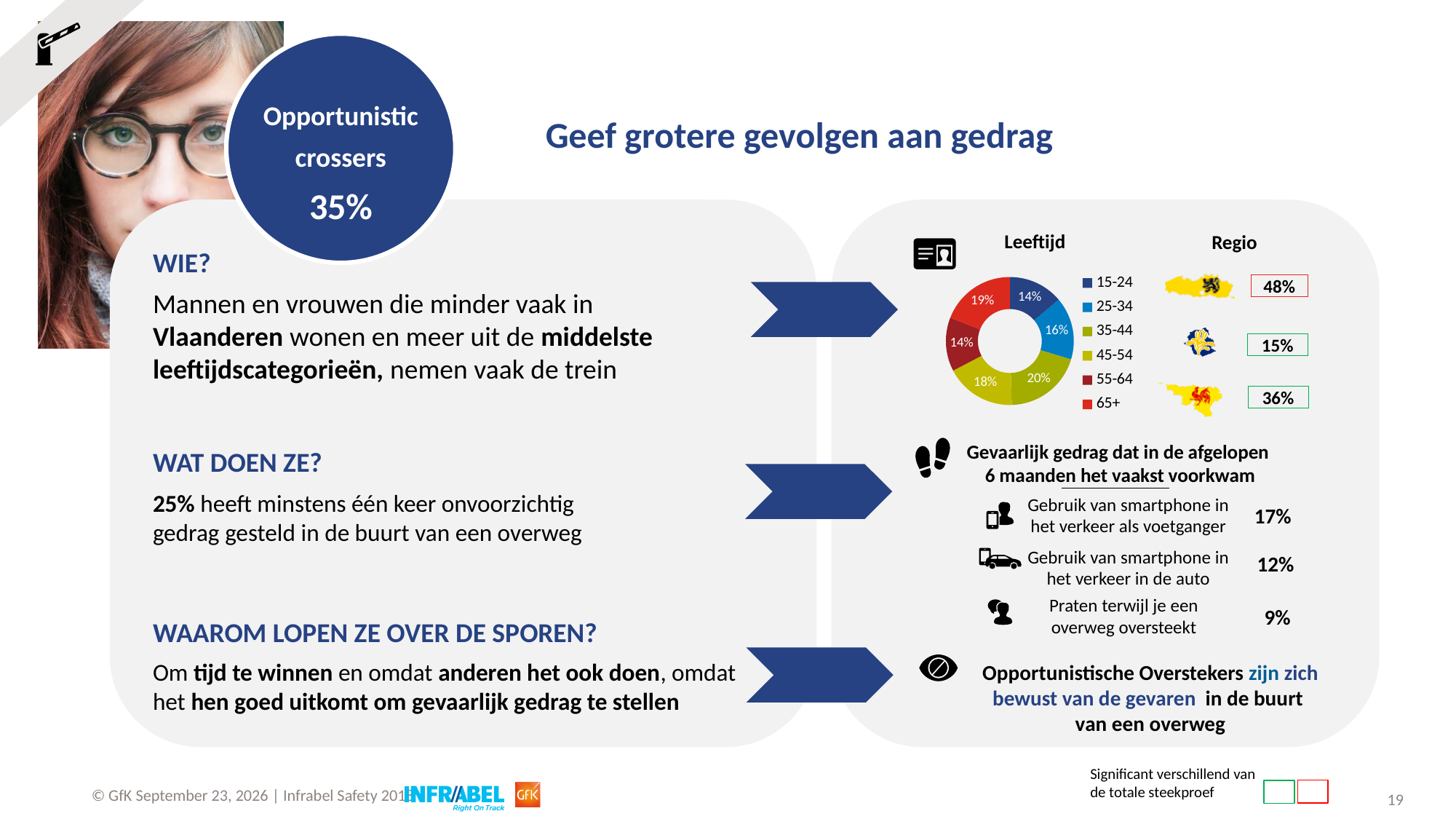
In the Leeftijd chart, which age group has the largest share? 35-44 In the Leeftijd chart, what is the difference in percentage points between the 35-44 and 25-34 age groups? 4 In the Leeftijd chart, what percentage is shown for the 35-44 age group? 20% What kind of chart is the Leeftijd chart? Pie (donut) chart What is the title of the pie chart on the slide? Leeftijd In the Leeftijd chart, what percentage is shown for the 25-34 age group? 16% In the Leeftijd chart, what percentage is shown for the 15-24 age group? 14% How many age categories does the Leeftijd chart show? 6 In the Leeftijd chart, what is the difference in percentage points between the 65+ and 55-64 age groups? 5 In the Leeftijd chart, which is larger: the share for 35-44 or the share for 25-34? 35-44 In the Leeftijd chart, what percentage is shown for the 45-54 age group? 18% In the Leeftijd chart, what percentage is shown for the 65+ age group? 19%